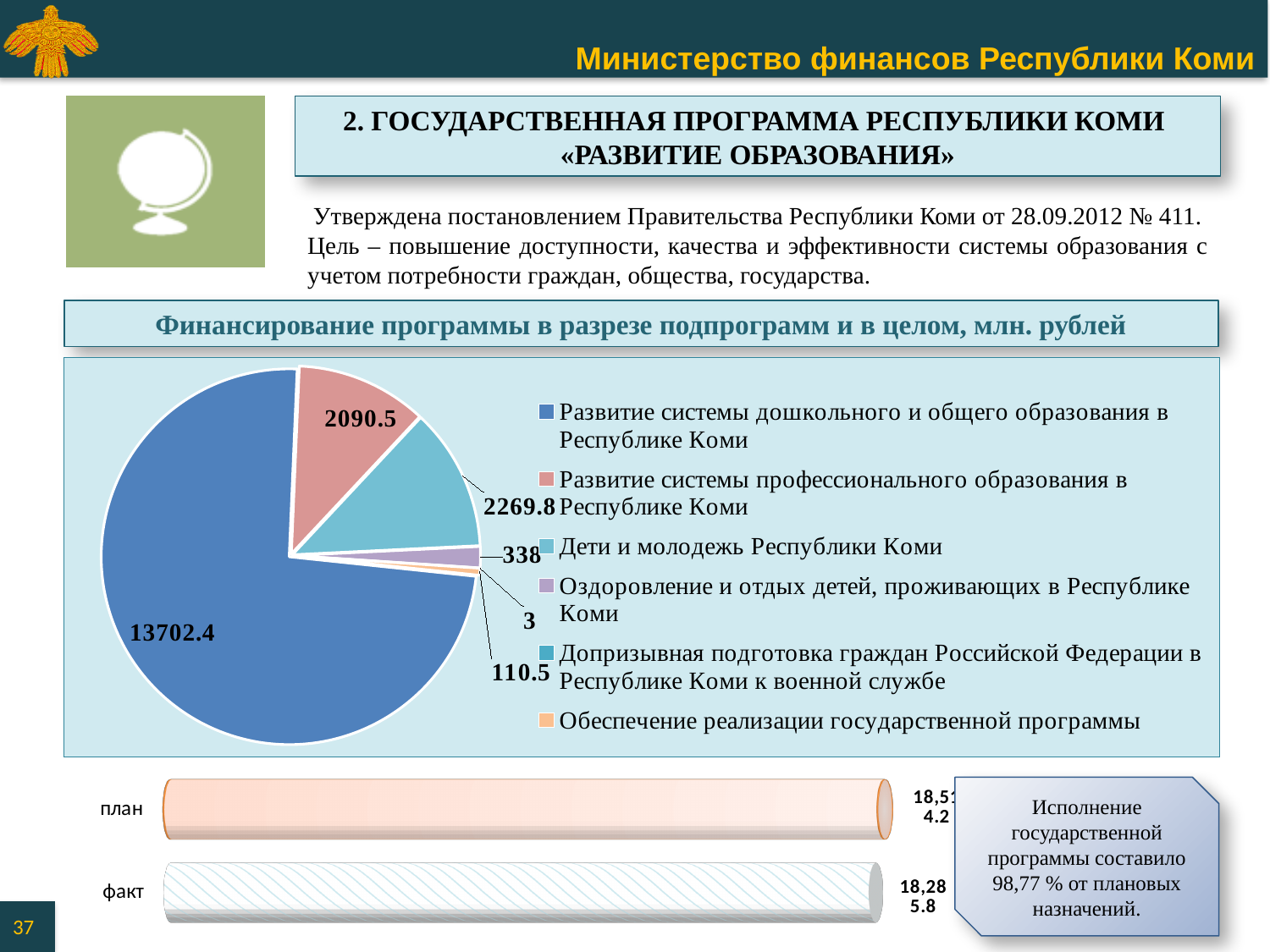
In the lower chart with «план» and «факт» bars, which bar is longer? план How many entries does the legend of the pie chart list? 6 In the pie chart, what is the value for «Развитие системы профессионального образования в Республике Коми»? 2090.5 In the pie chart, what is the difference between «Дети и молодежь Республики Коми» and «Развитие системы профессионального образования в Республике Коми»? 179.3 In the pie chart, which is larger: «Дети и молодежь Республики Коми» or «Развитие системы профессионального образования в Республике Коми»? Дети и молодежь Республики Коми In the pie chart, what is the value for «Оздоровление и отдых детей, проживающих в Республике Коми»? 338 In the pie chart, what is the value for «Дети и молодежь Республики Коми»? 2269.8 In the pie chart, which subprogram has the largest slice? Развитие системы дошкольного и общего образования в Республике Коми In the pie chart, what is the value for «Развитие системы дошкольного и общего образования в Республике Коми»? 13702.4 What kind of chart is the upper chart on the slide (Финансирование программы в разрезе подпрограмм и в целом)? pie chart In the pie chart, which subprogram has the smallest slice? Допризывная подготовка граждан Российской Федерации в Республике Коми к военной службе What kind of chart is the lower chart showing «план» and «факт»? bar chart